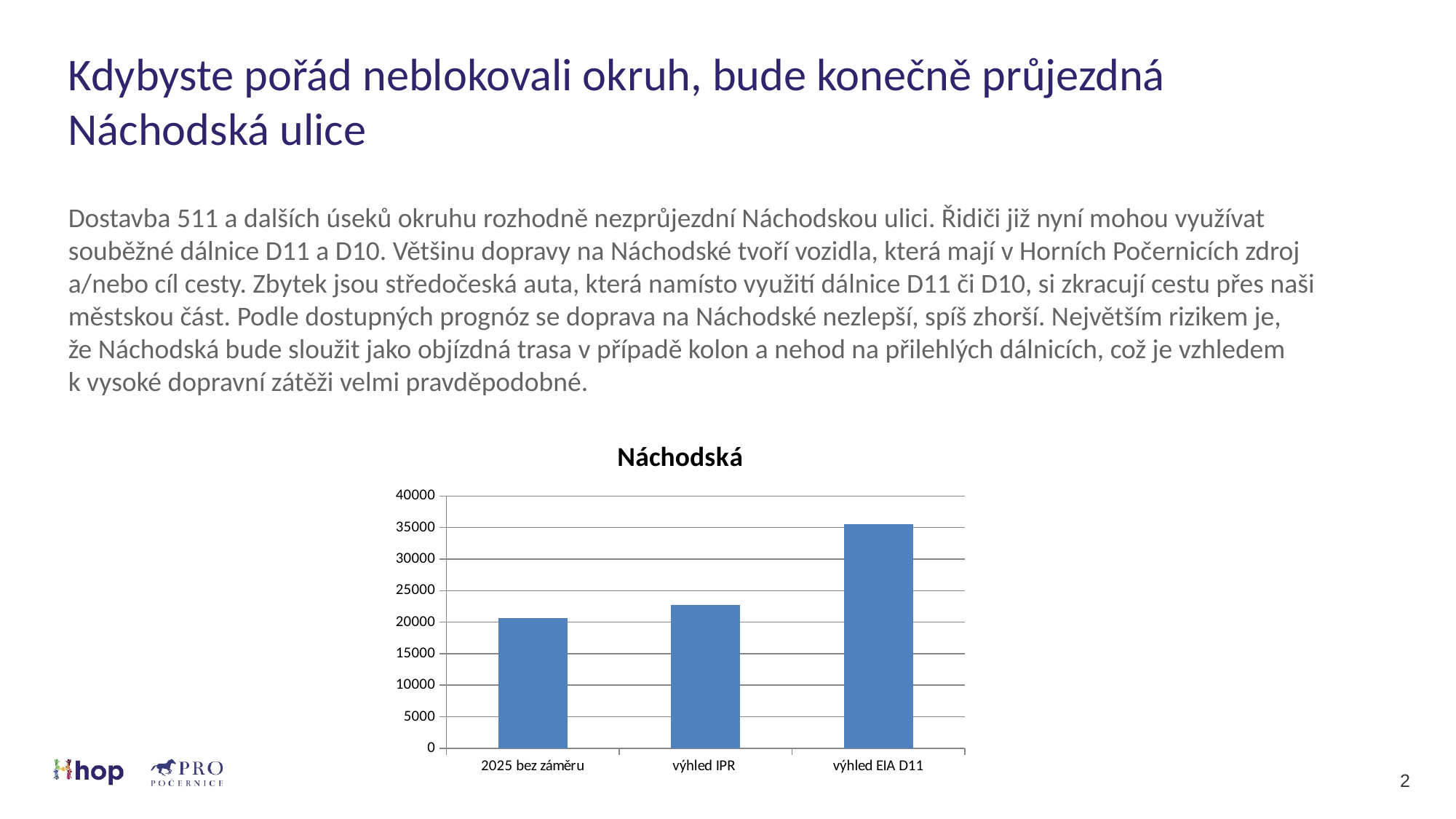
Which is larger, the value for výhled IPR or the value for výhled EIA D11? výhled EIA D11 Is the value for výhled EIA D11 greater or less than 30000? greater Is the value for výhled IPR greater or less than 20000? greater What is the title of the chart? Náchodská What kind of chart is shown on the slide? bar chart Which category has the highest value in the chart? výhled EIA D11 What is the highest value shown on the y axis of the chart? 40000 Which is larger, the value for 2025 bez záměru or the value for výhled IPR? výhled IPR Which category has the lowest value in the chart? 2025 bez záměru Is the value for 2025 bez záměru greater or less than 25000? less How many categories are shown on the x axis of the chart? 3 Do the values rise or fall from left to right along the x axis? rise